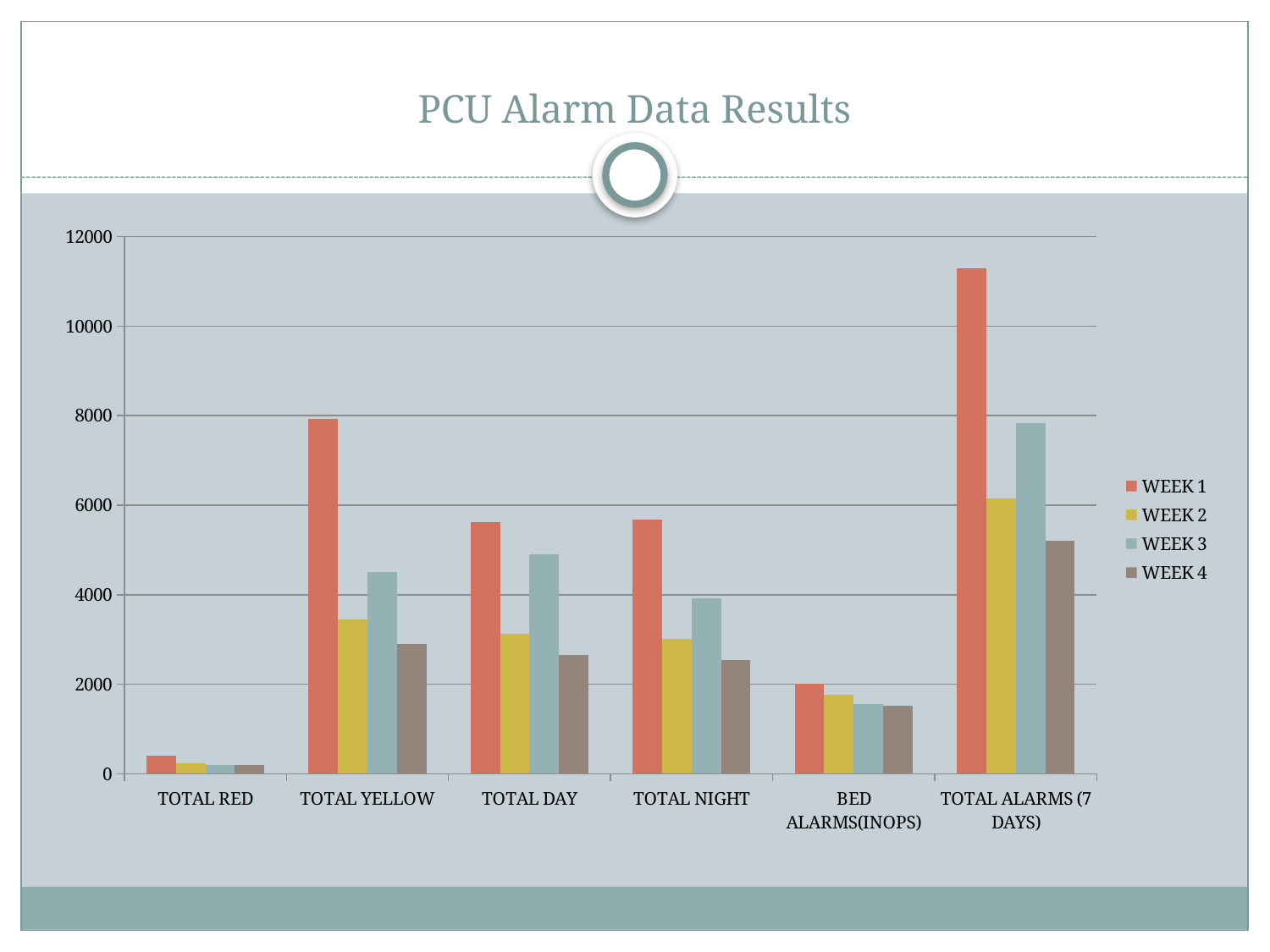
What is the title of the slide containing the chart? PCU Alarm Data Results Is the WEEK 2 value for BED ALARMS(INOPS) greater or less than 2000? less For TOTAL DAY, which is larger: the WEEK 2 value or the WEEK 3 value? WEEK 3 How many categories are shown on the x axis? 6 Which category has the lowest WEEK 1 bar? TOTAL RED What kind of chart is shown on the slide? bar chart Is the WEEK 4 value for TOTAL ALARMS (7 DAYS) greater or less than 6000? less Which category has the highest WEEK 1 bar? TOTAL ALARMS (7 DAYS) Is the WEEK 1 value for TOTAL ALARMS (7 DAYS) greater or less than 10000? greater For TOTAL NIGHT, which week has the highest value? WEEK 1 How many series does the legend list? 4